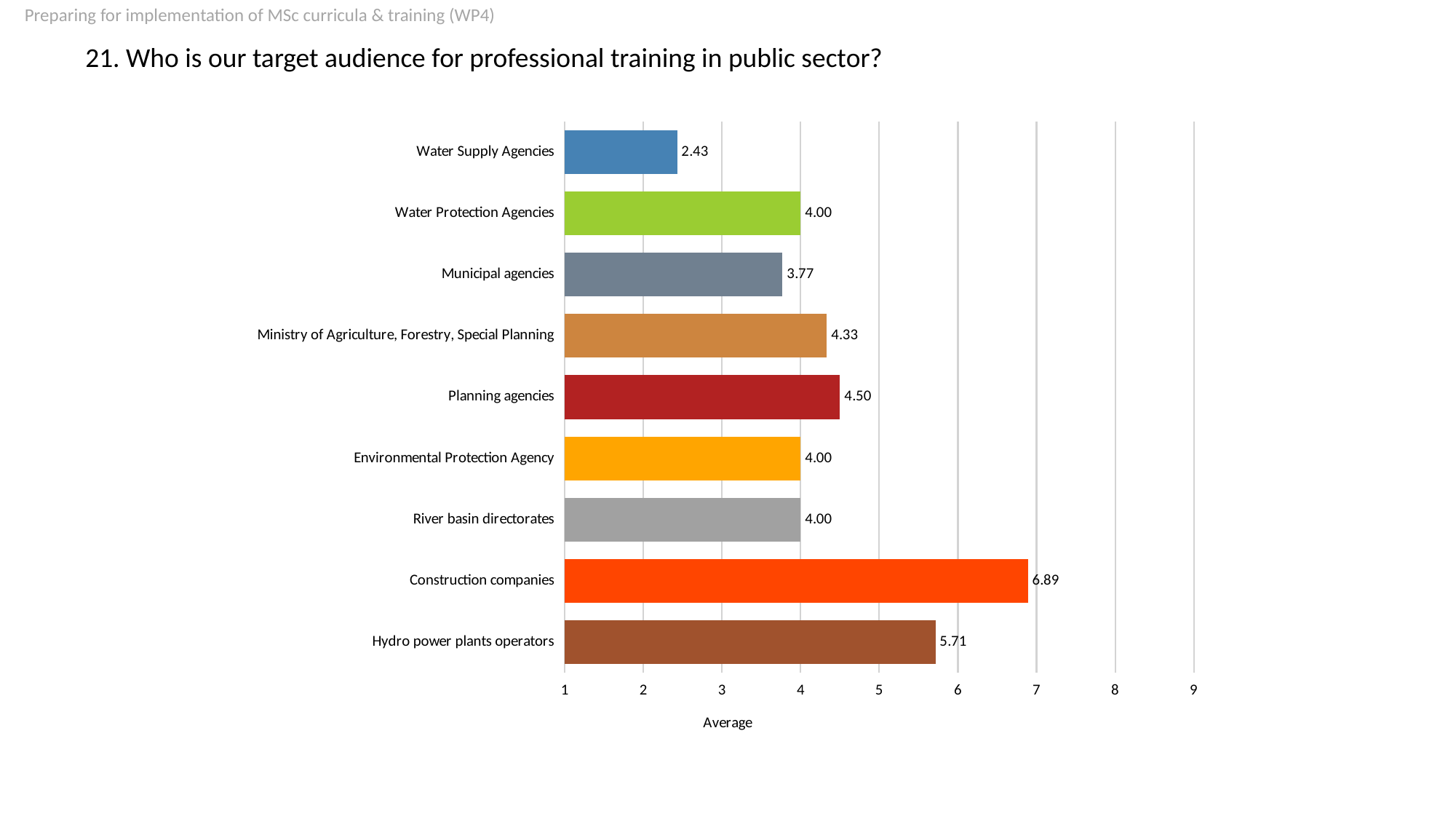
How many categories are shown in the chart? 9 What kind of chart is shown on the slide? Bar chart Which has a larger average value, Planning agencies or Municipal agencies? Planning agencies What is the average value for Hydro power plants operators? 5.71 Which category has the lowest average value? Water Supply Agencies What is the difference between the average values for Construction companies and Hydro power plants operators? 1.18 What is the label of the horizontal axis? Average What is the average value for Water Supply Agencies? 2.43 What is the average value for Ministry of Agriculture, Forestry, Special Planning? 4.33 Which category has the highest average value? Construction companies What is the average value for Construction companies? 6.89 Is the value for Hydro power plants operators greater or less than 5? greater